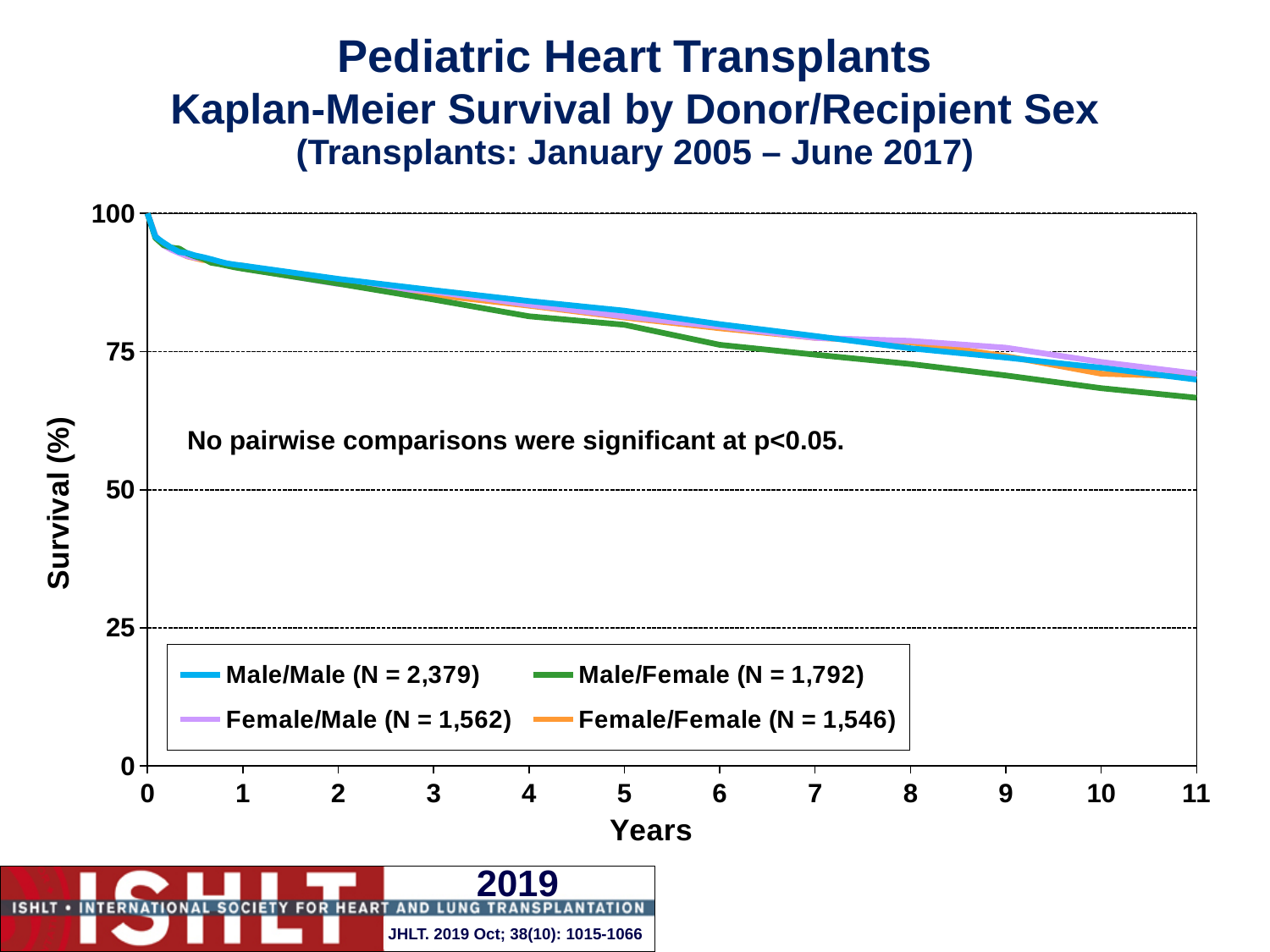
Is the survival for the Male/Female group at 11 years greater or less than 75? less How many series does the legend list? 4 What is the N for the Male/Male group shown in the legend? 2,379 What kind of chart is shown on the slide? line chart Which donor/recipient sex group has the smallest N in the legend? Female/Female At 11 years, which curve is higher: Male/Male or Male/Female? Male/Male Do the survival curves rise or fall as years increase? fall Which donor/recipient sex group has the largest N in the legend? Male/Male What is the N for the Female/Female group shown in the legend? 1,546 What is the difference between the N for Male/Male and the N for Male/Female? 587 What is the label of the y axis? Survival (%) Is the survival for the Male/Female group at 4 years greater or less than 75? greater